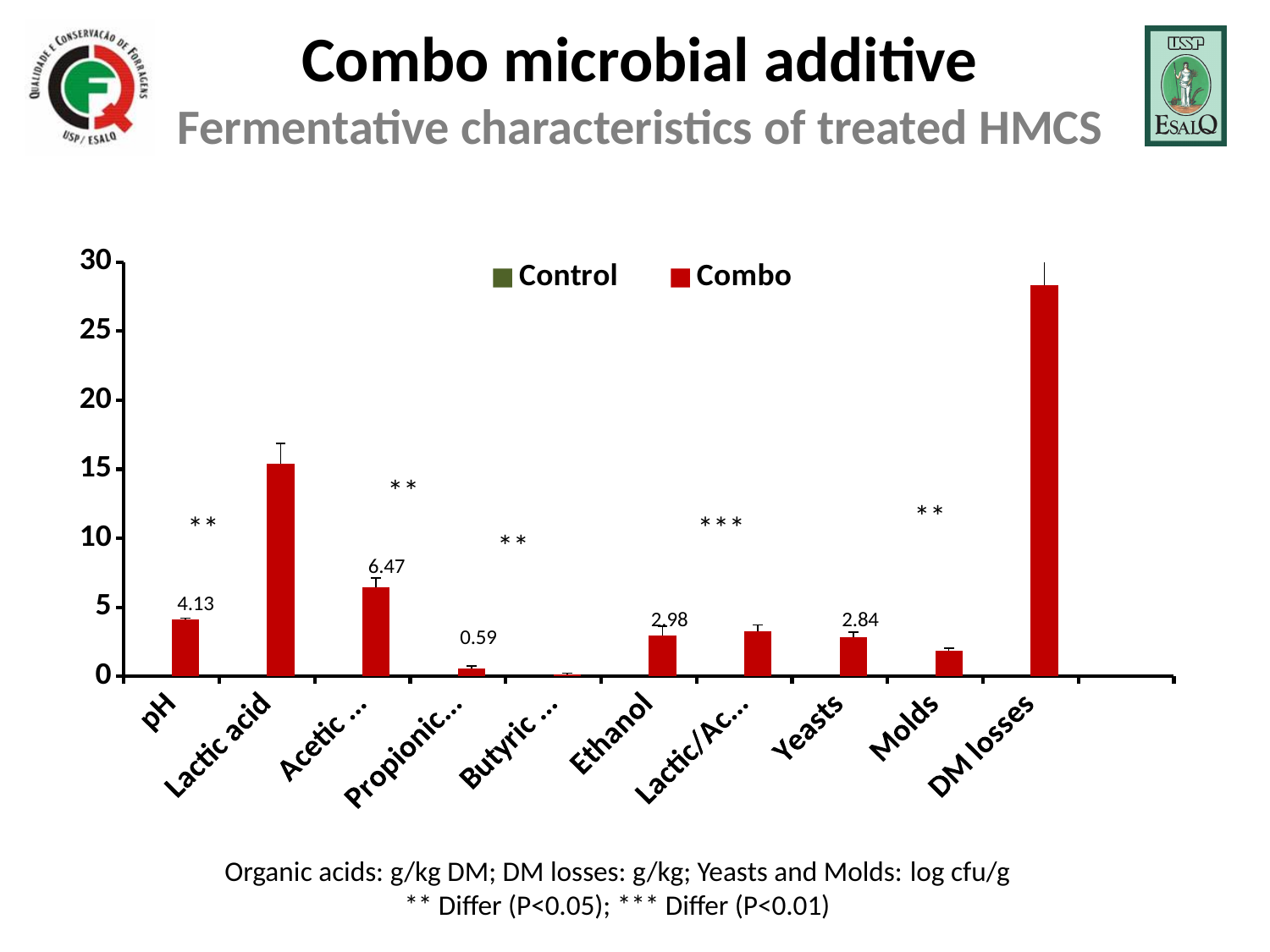
What value is labelled for pH on the chart? 4.13 What value is labelled for Ethanol on the chart? 2.98 Is the bar for Lactic acid greater or less than 10? greater How many series does the chart legend list? 2 What is the difference between the labelled values for Ethanol (2.98) and Yeasts (2.84)? 0.14 What colour are the Combo bars in the chart? red Which category has the tallest bar on the chart? DM losses How many categories are shown along the x axis of the chart? 10 What value is labelled for Yeasts on the chart? 2.84 Is the bar for DM losses greater or less than 25? greater Is the bar for Molds greater or less than 5? less What kind of chart is shown on the slide? bar chart